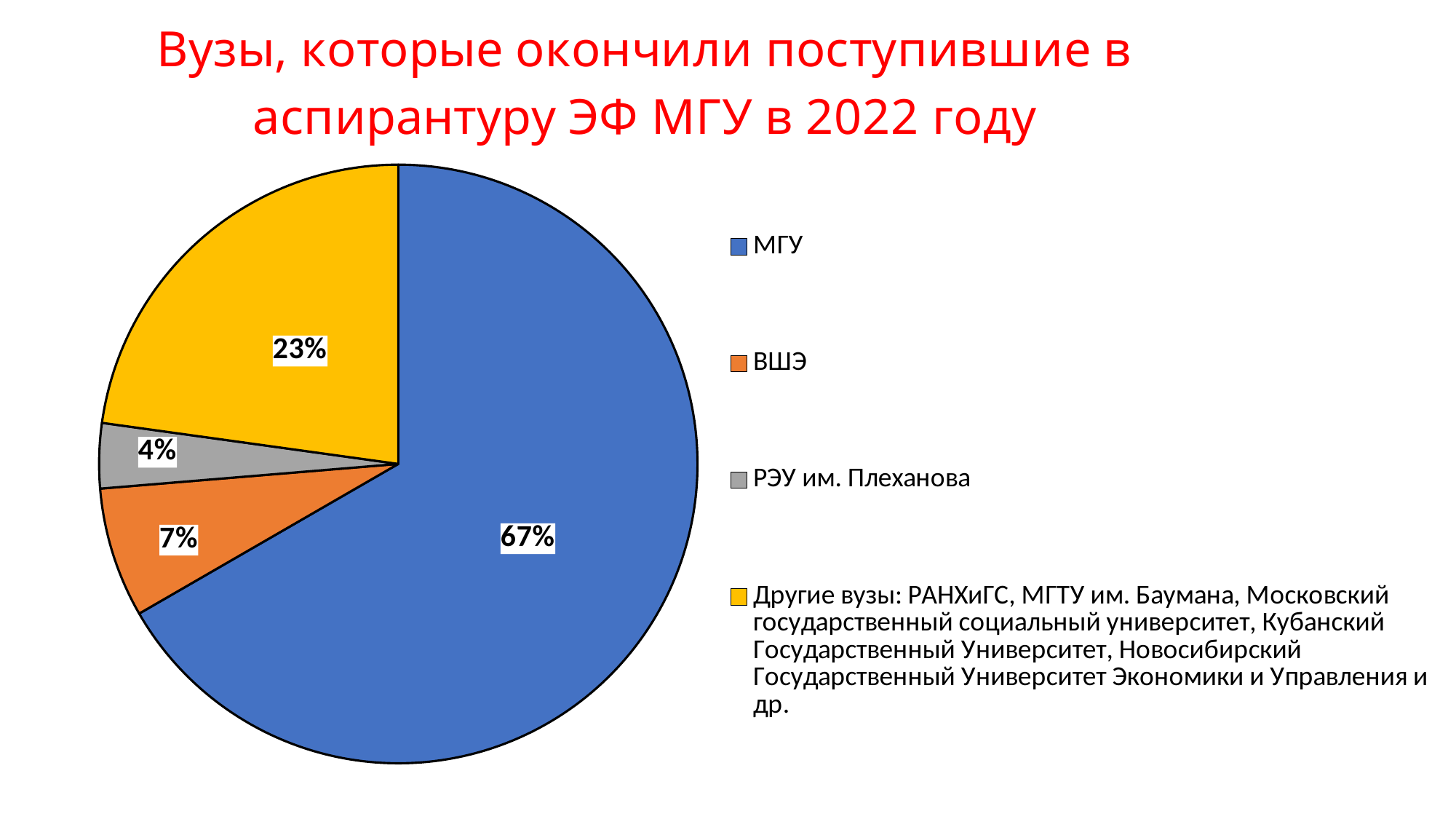
What is the difference in percentage points between the МГУ slice and the 'Другие вузы' slice? 44 What share of the pie does РЭУ им. Плеханова account for? 4% What share of the pie does ВШЭ account for? 7% Which category has the largest slice of the pie? МГУ How many slices does the pie chart have? 4 What kind of chart is shown on the slide? Pie chart What colour is the slice for МГУ? Blue Which category has the smallest slice of the pie? РЭУ им. Плеханова Which is larger, the ВШЭ slice or the 'Другие вузы' slice? Другие вузы What share of the pie does МГУ account for? 67% What is the difference in percentage points between the ВШЭ slice and the РЭУ им. Плеханова slice? 3